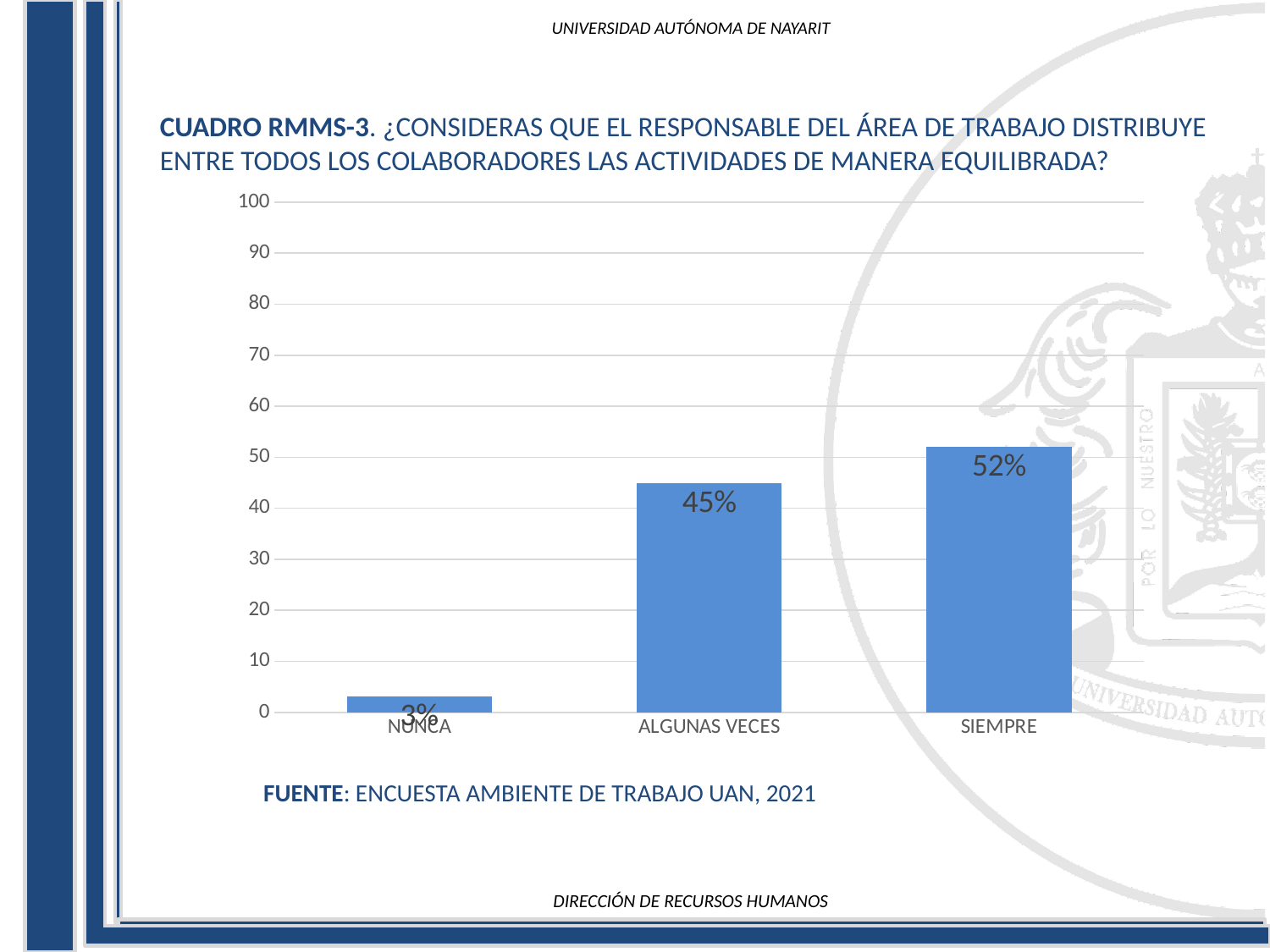
How many categories are shown on the x axis? 3 Which category has the lowest value? NUNCA Is the value for SIEMPRE greater or less than 50? greater What is the difference between the values for ALGUNAS VECES and NUNCA? 42% What is the value for ALGUNAS VECES? 45% Which category has the highest value? SIEMPRE What is the difference between the values for SIEMPRE and ALGUNAS VECES? 7% What is the value for SIEMPRE? 52% What kind of chart is shown on the slide? bar chart Which is larger, the value for SIEMPRE or the value for ALGUNAS VECES? SIEMPRE Do the values rise or fall from left to right along the x axis? rise What is the value for NUNCA? 3%